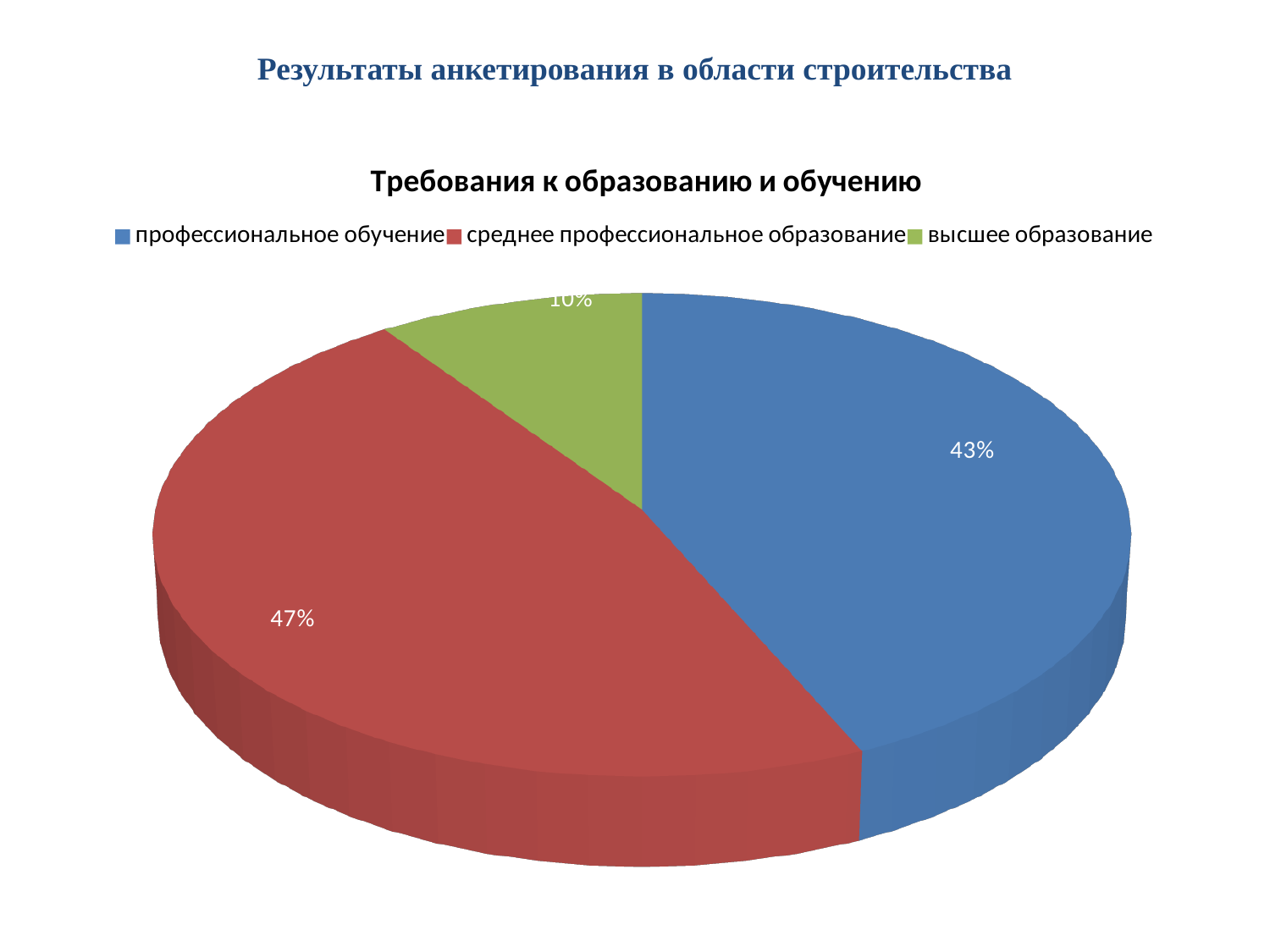
How many entries does the legend list? 3 Which category has the smallest slice of the pie? высшее образование Which colour represents "высшее образование" in the chart? Green What kind of chart is shown on the slide? Pie chart What share of the pie does "профессиональное обучение" have? 43% What is the difference in percentage points between "среднее профессиональное образование" and "профессиональное обучение"? 4 Which category has the largest slice of the pie? среднее профессиональное образование What share of the pie does "среднее профессиональное образование" have? 47% What share of the pie does "высшее образование" have? 10% What is the title of the chart? Требования к образованию и обучению How many slices does the pie chart have? 3 What is the difference in percentage points between "профессиональное обучение" and "высшее образование"? 33